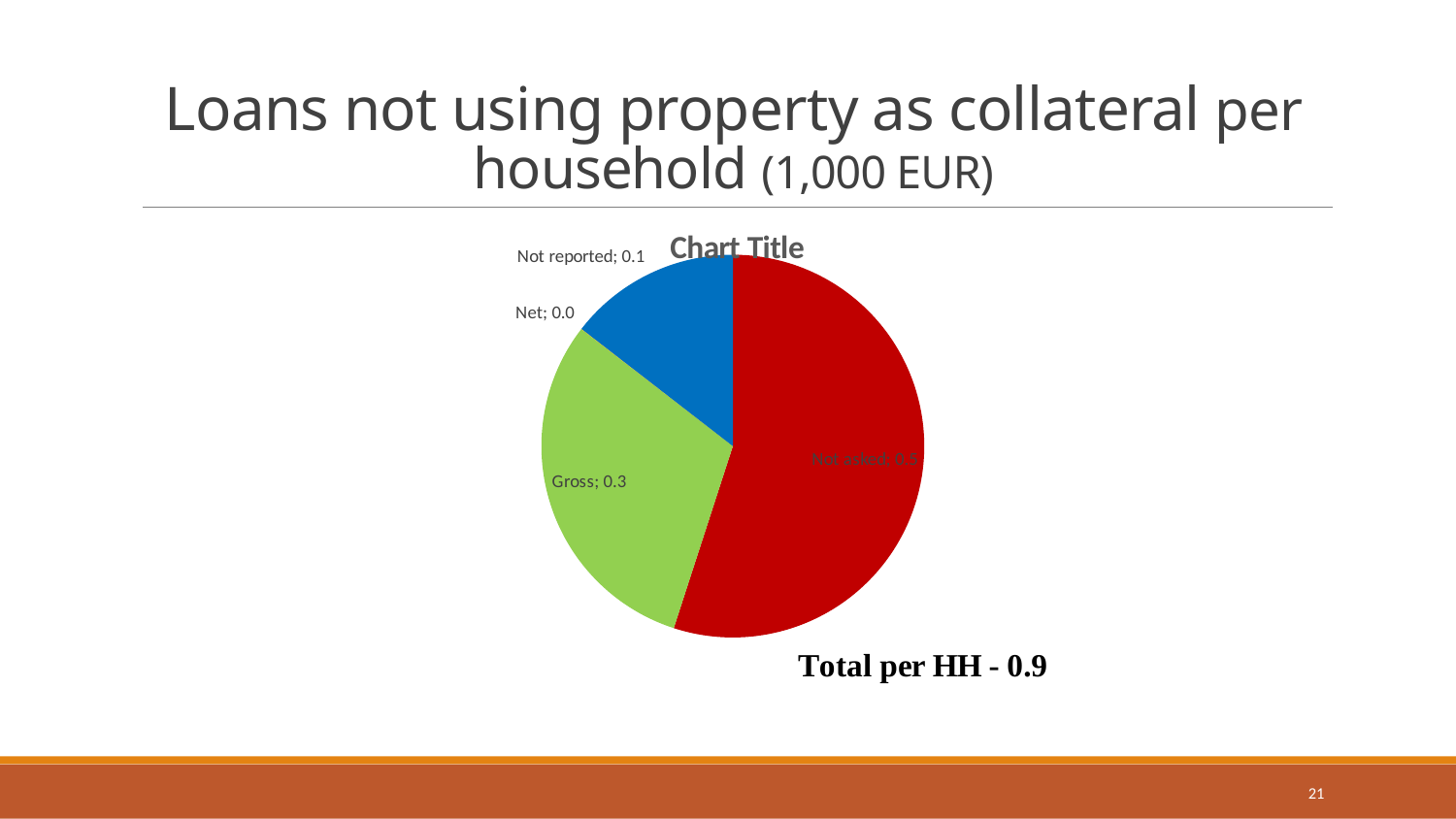
What kind of chart is shown on the slide? pie chart What is the value for Not reported in the pie chart? 0.1 What is the value for Gross in the pie chart? 0.3 What title is printed above the pie chart? Chart Title What is the value for Not asked in the pie chart? 0.5 Which category has the largest slice in the pie chart? Not asked How many categories are labelled in the pie chart? 4 Which category has the smallest value in the pie chart? Net What is the difference between the value for Gross and the value for Not reported? 0.2 What colour is the Gross slice in the pie chart? green Which is larger, the value for Gross or the value for Not reported? Gross What is the value for Net in the pie chart? 0.0